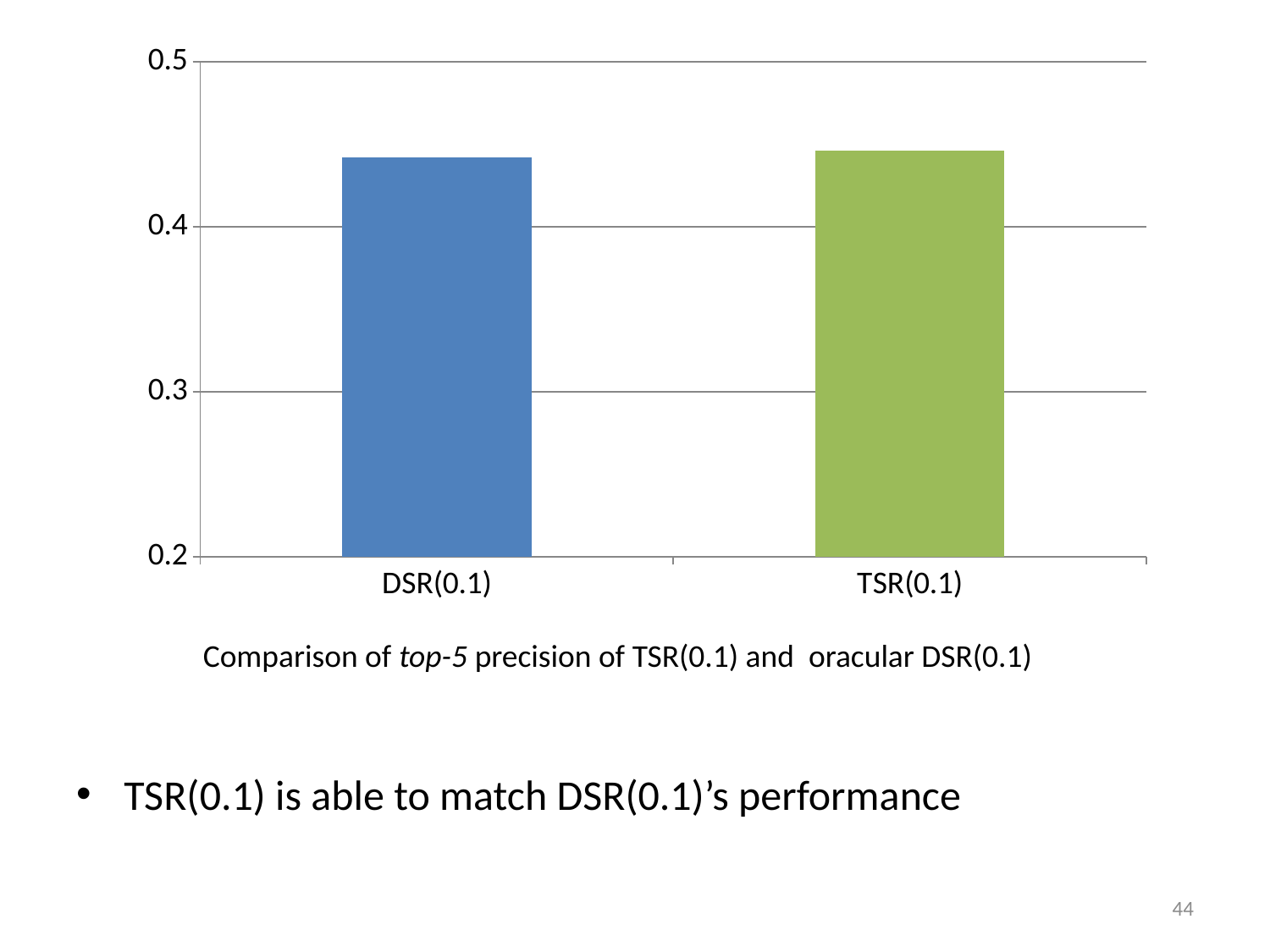
Is the value for TSR(0.1) greater or less than 0.5? less What kind of chart is shown on the slide? bar chart Is the value for DSR(0.1) greater or less than 0.4? greater How many categories are plotted on the x axis of the chart? 2 What are the two category labels on the x axis of the chart? DSR(0.1) and TSR(0.1) Is the value for DSR(0.1) greater or less than 0.5? less What is the lowest value shown on the y axis of the chart? 0.2